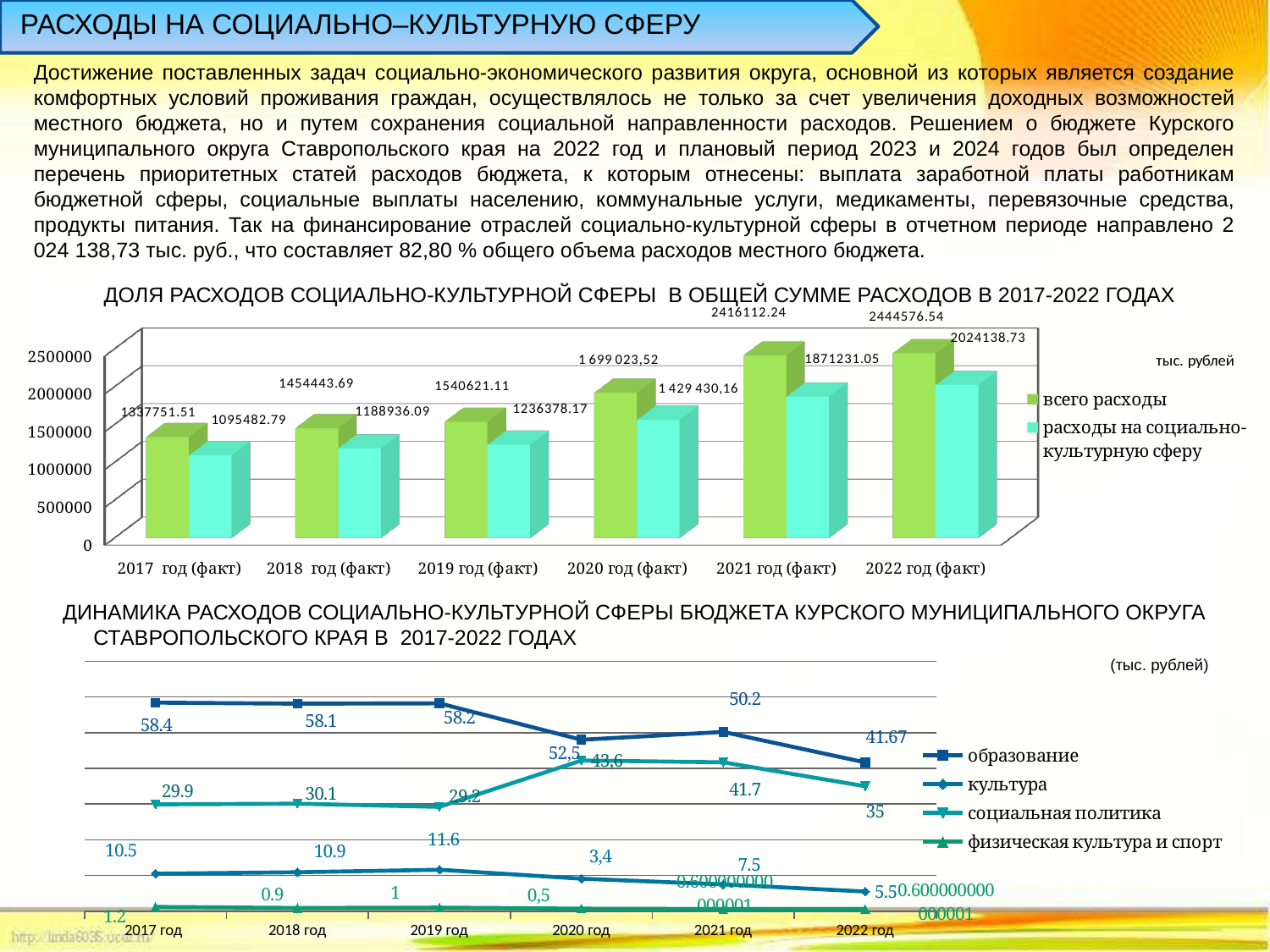
What kind of chart is the top chart, 'ДОЛЯ РАСХОДОВ СОЦИАЛЬНО-КУЛЬТУРНОЙ СФЕРЫ В ОБЩЕЙ СУММЕ РАСХОДОВ В 2017-2022 ГОДАХ'? Bar chart In the top bar chart, which year has the lowest value for 'всего расходы'? 2017 год (факт) In the top bar chart, how many series does the legend list? 2 In the top bar chart, what is the value of 'всего расходы' for 2021 год (факт)? 2416112.24 In the top bar chart, is the value of 'всего расходы' for 2020 год (факт) greater or less than 1500000? greater In the top bar chart, what is the difference between 'всего расходы' and 'расходы на социально-культурную сферу' in 2022 год (факт)? 420437.81 In the top bar chart, what is the value of 'расходы на социально-культурную сферу' for 2019 год (факт)? 1236378.17 In the bottom line chart, how many series does the legend list? 4 In the bottom line chart, what is the value for 'социальная политика' in 2020 год? 43,6 In the bottom line chart 'ДИНАМИКА РАСХОДОВ...', what is the value for 'образование' in 2017 год? 58.4 In the bottom line chart, does the 'образование' line rise or fall overall from 2017 год to 2022 год? Fall In the bottom line chart, which is larger in 2021 год: 'культура' or 'социальная политика'? социальная политика